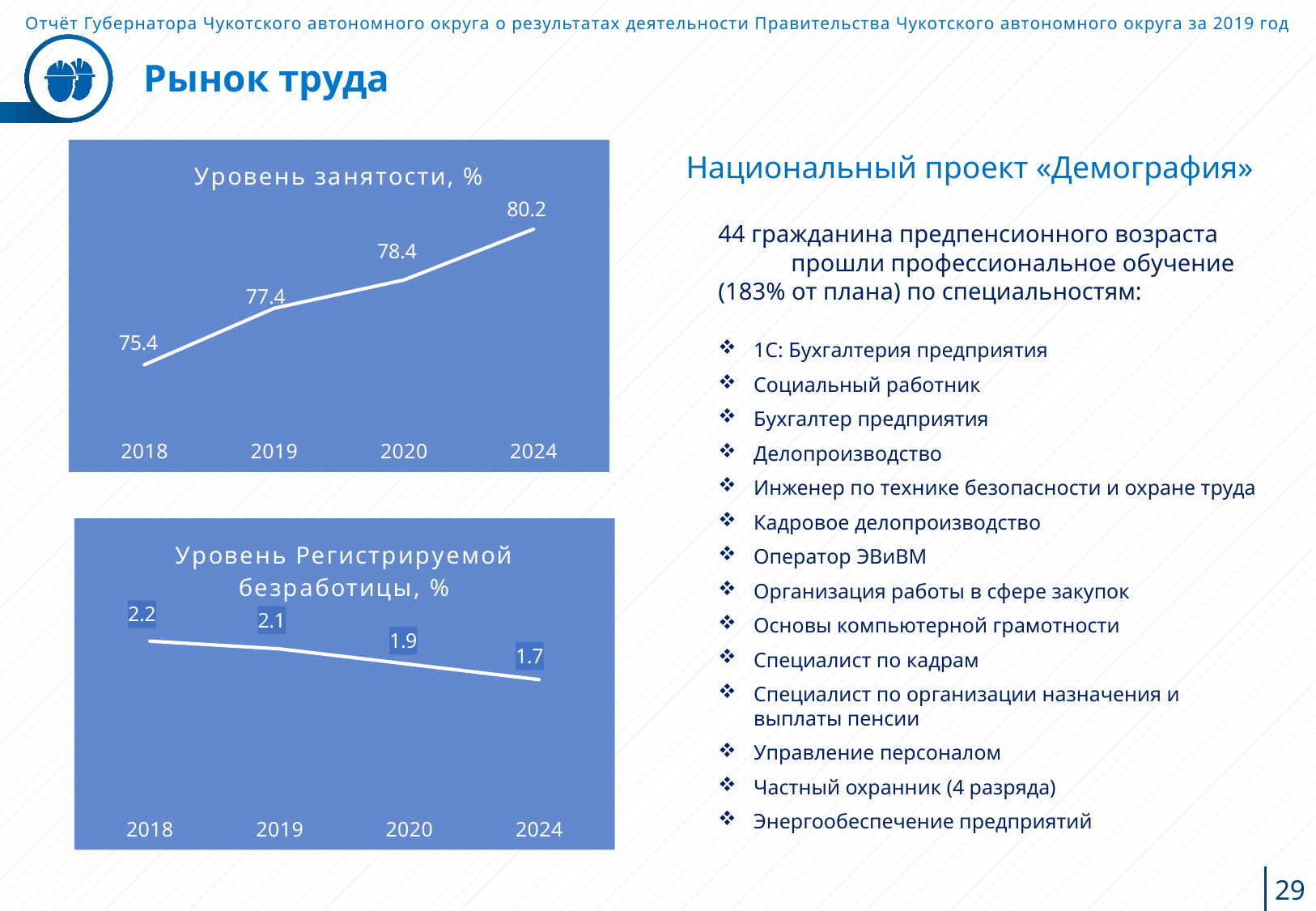
In the chart "Уровень Регистрируемой безработицы, %", do the values rise or fall from 2018 to 2024? fall How many data points are plotted in the chart "Уровень занятости, %"? 4 In the chart "Уровень занятости, %", what is the value for 2024? 80.2 In the chart "Уровень Регистрируемой безработицы, %", which year has the lowest value? 2024 In the chart "Уровень Регистрируемой безработицы, %", what is the value for 2020? 1.9 In the chart "Уровень Регистрируемой безработицы, %", is the value for 2018 or 2019 larger? 2018 In the chart "Уровень Регистрируемой безработицы, %", what is the difference between the values for 2018 and 2024? 0.5 In the chart "Уровень занятости, %", what is the difference between the values for 2020 and 2019? 1.0 In the chart "Уровень занятости, %", what is the value for 2018? 75.4 In the chart "Уровень занятости, %", which year has the highest value? 2024 What type of chart is the bottom chart on the slide? line chart In the chart "Уровень занятости, %", do the values rise or fall from 2018 to 2024? rise